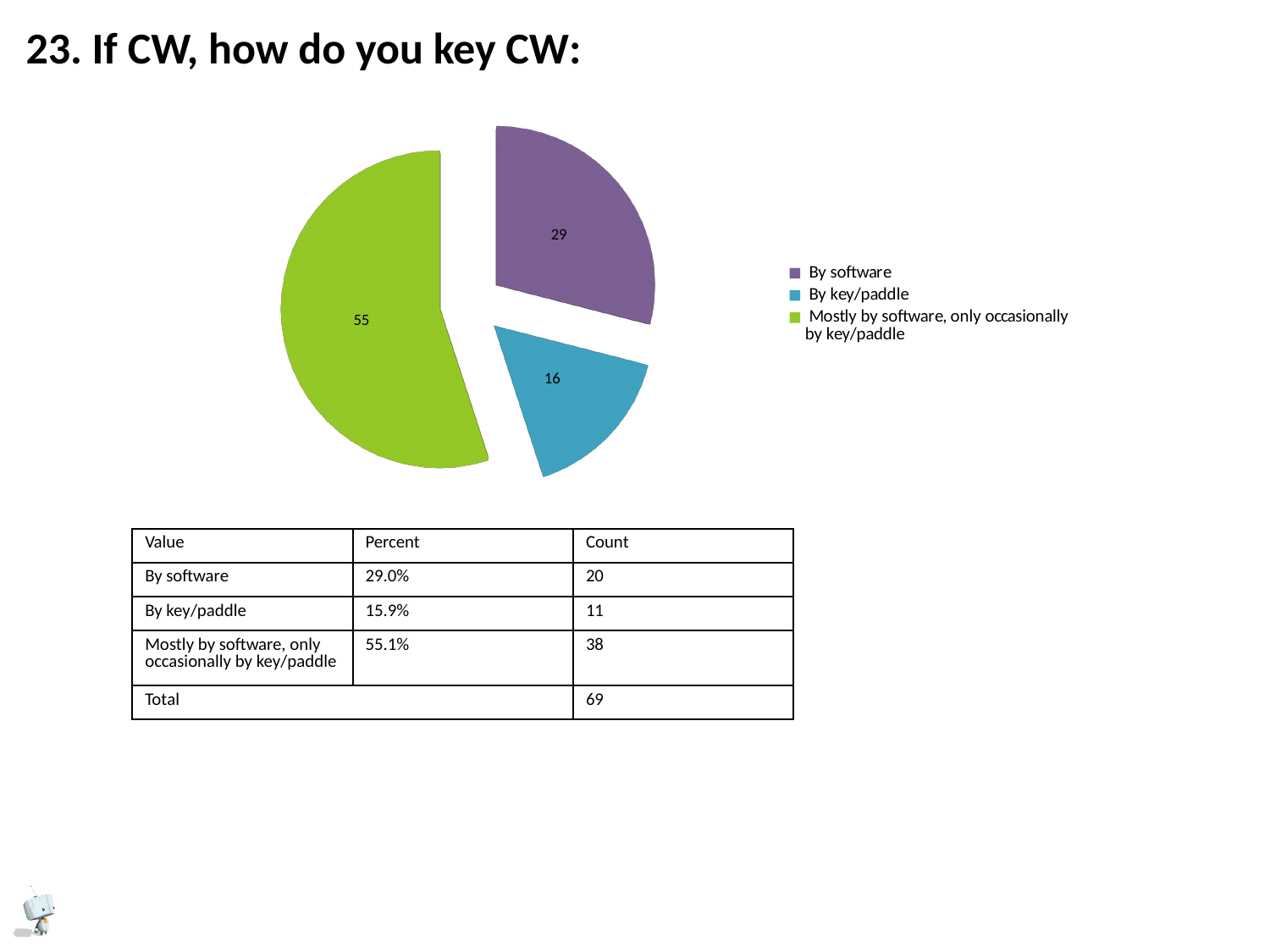
What colour is the 'Mostly by software, only occasionally by key/paddle' slice in the pie chart? green Which category has the smallest slice in the pie chart? By key/paddle Which category has the largest slice in the pie chart? Mostly by software, only occasionally by key/paddle What colour is the 'By key/paddle' slice in the pie chart? blue What is the data label on the pie slice for 'Mostly by software, only occasionally by key/paddle'? 55 What is the difference between the data labels for 'Mostly by software, only occasionally by key/paddle' and 'By software' in the pie chart? 26 What type of chart is shown on the slide? pie chart What is the data label on the pie slice for 'By software'? 29 How many slices does the pie chart have? 3 Which slice is larger in the pie chart: 'By software' or 'By key/paddle'? By software How many entries does the legend of the pie chart list? 3 What is the data label on the pie slice for 'By key/paddle'? 16